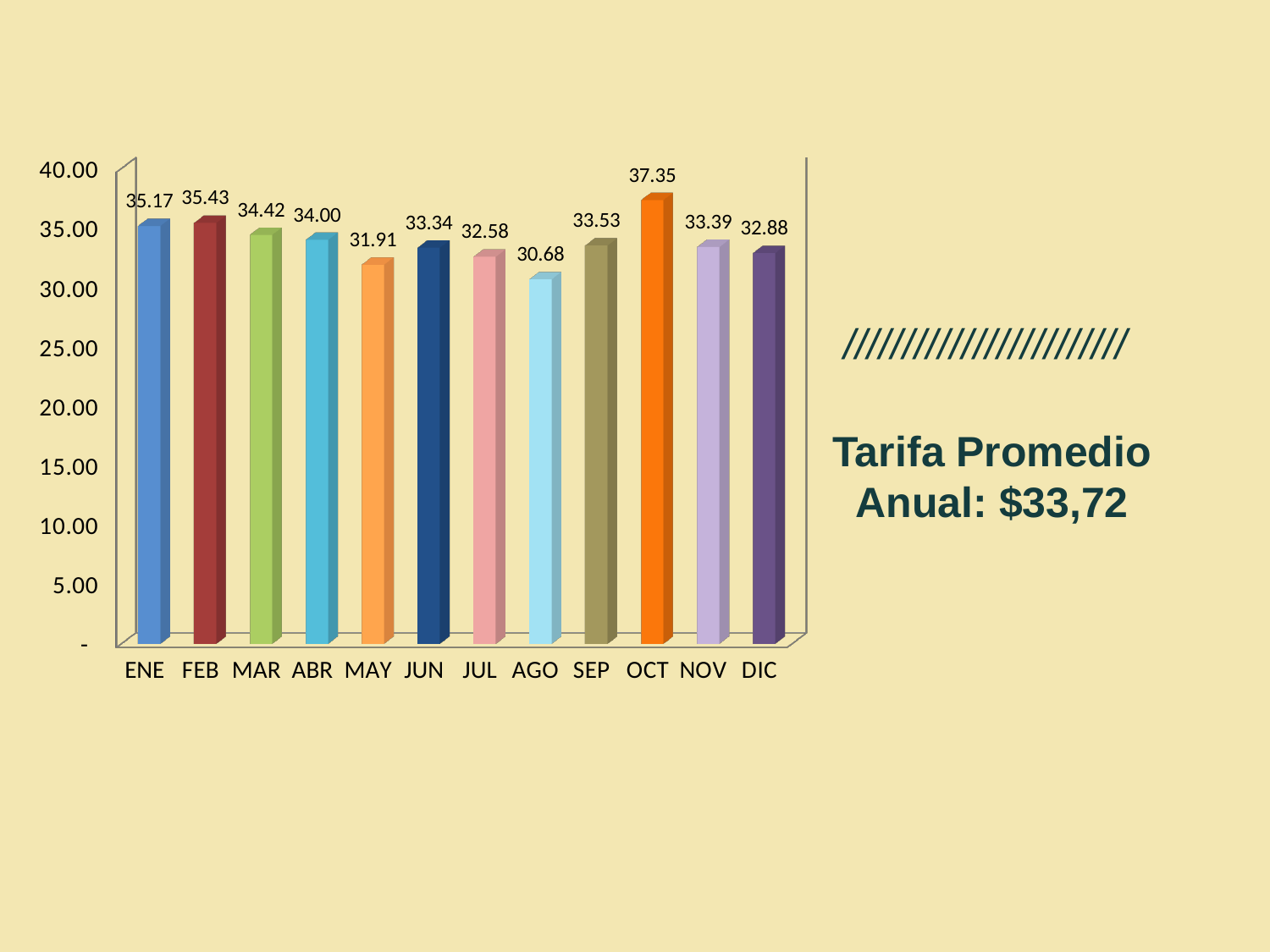
What is the value for OCT? 37.35 Which is larger, the value for MAY or the value for JUN? JUN Is the value for SEP greater or less than 30.00? greater What annual average rate is stated in the text next to the chart? $33,72 What is the difference between the values for OCT and AGO? 6.67 Which month has the lowest value? AGO What kind of chart is shown on the slide? bar chart How many months are shown on the x axis? 12 Which month has the highest value? OCT What is the value for AGO? 30.68 What is the difference between the values for ENE and FEB? 0.26 What is the value for MAR? 34.42